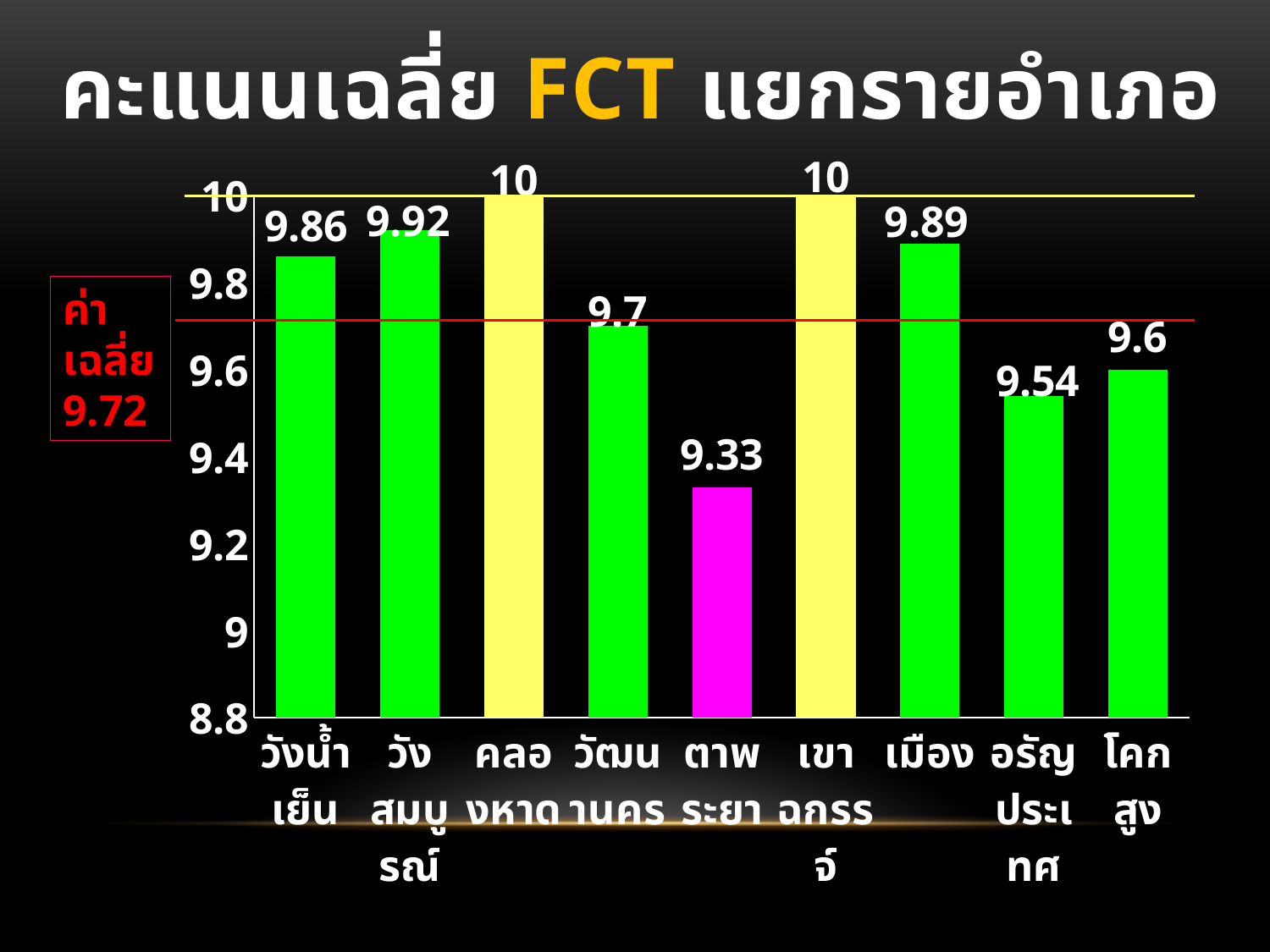
What is the value for เมือง? 9.89 What colour is the bar for ตาพระยา? magenta Which districts have the highest value of 10? คลองหาด and เขาฉกรรจ์ Which is larger, the value for วัฒนานคร or the value for อรัญประเทศ? วัฒนานคร What kind of chart is shown on the slide? bar chart What is the value for วังน้ำเย็น? 9.86 Which district has the lowest value? ตาพระยา What is the value for ตาพระยา? 9.33 How many districts are shown on the chart? 9 What is the value for อรัญประเทศ? 9.54 What overall average value (ค่าเฉลี่ย) is marked by the red line on the chart? 9.72 What is the difference between the values for วังสมบูรณ์ and โคกสูง? 0.32